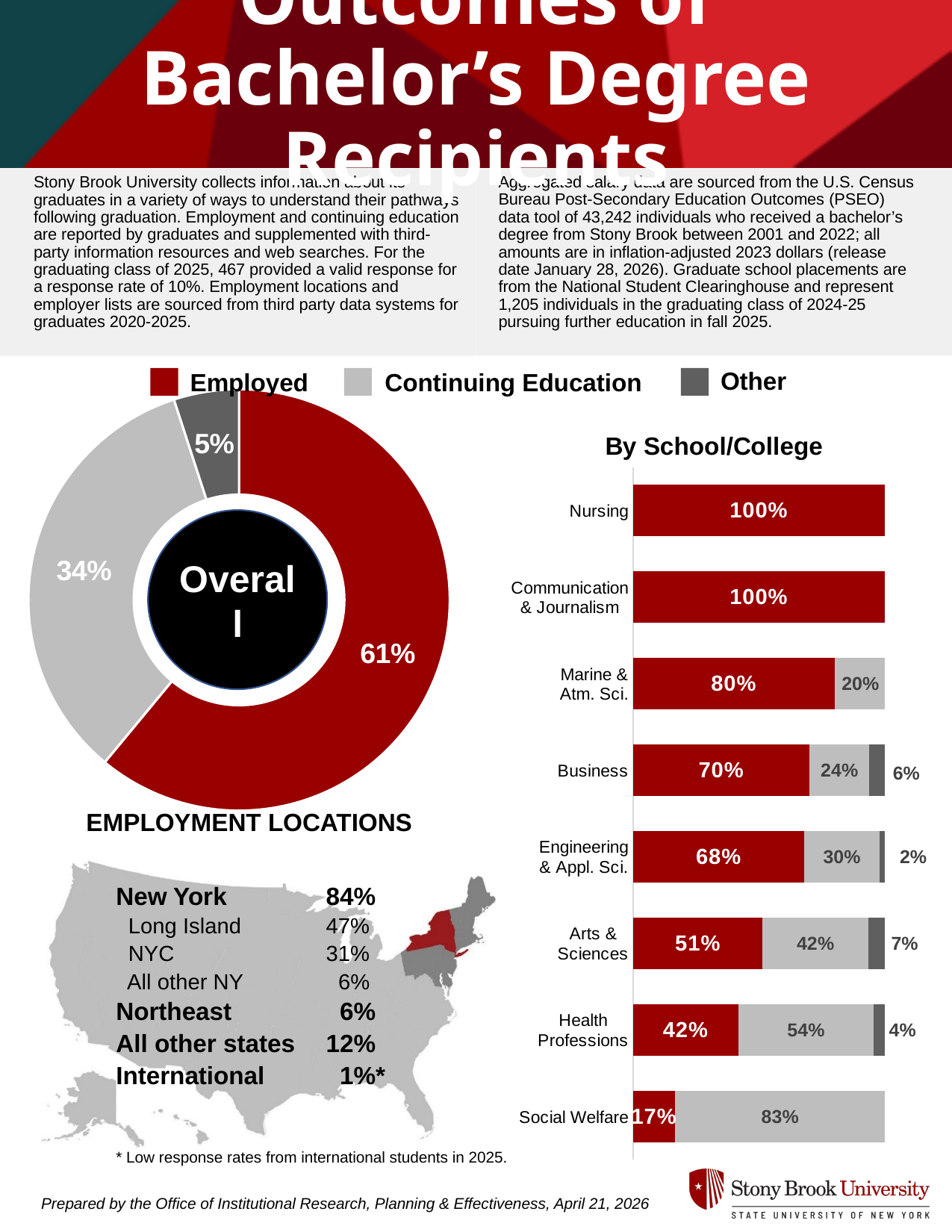
In the Overall donut chart, what share of graduates are Employed? 61% How many schools/colleges are shown in the By School/College chart? 8 In the By School/College chart, what is the Continuing Education percentage for Health Professions? 54% What kind of chart is the By School/College chart? Stacked bar chart In the By School/College chart, which is larger: the Employed percentage for Marine & Atm. Sci. or for Engineering & Appl. Sci.? Marine & Atm. Sci. In the Overall donut chart, what share of graduates are in Continuing Education? 34% In the By School/College chart, what is the Employed percentage for Business? 70% In the By School/College chart, which school has the lowest Employed percentage? Social Welfare How many series does the legend list? 3 In the Overall donut chart, which category has the smallest share? Other In the By School/College chart, what is the Other percentage for Arts & Sciences? 7% In the Overall donut chart, what is the difference between the Employed share and the Continuing Education share? 27%